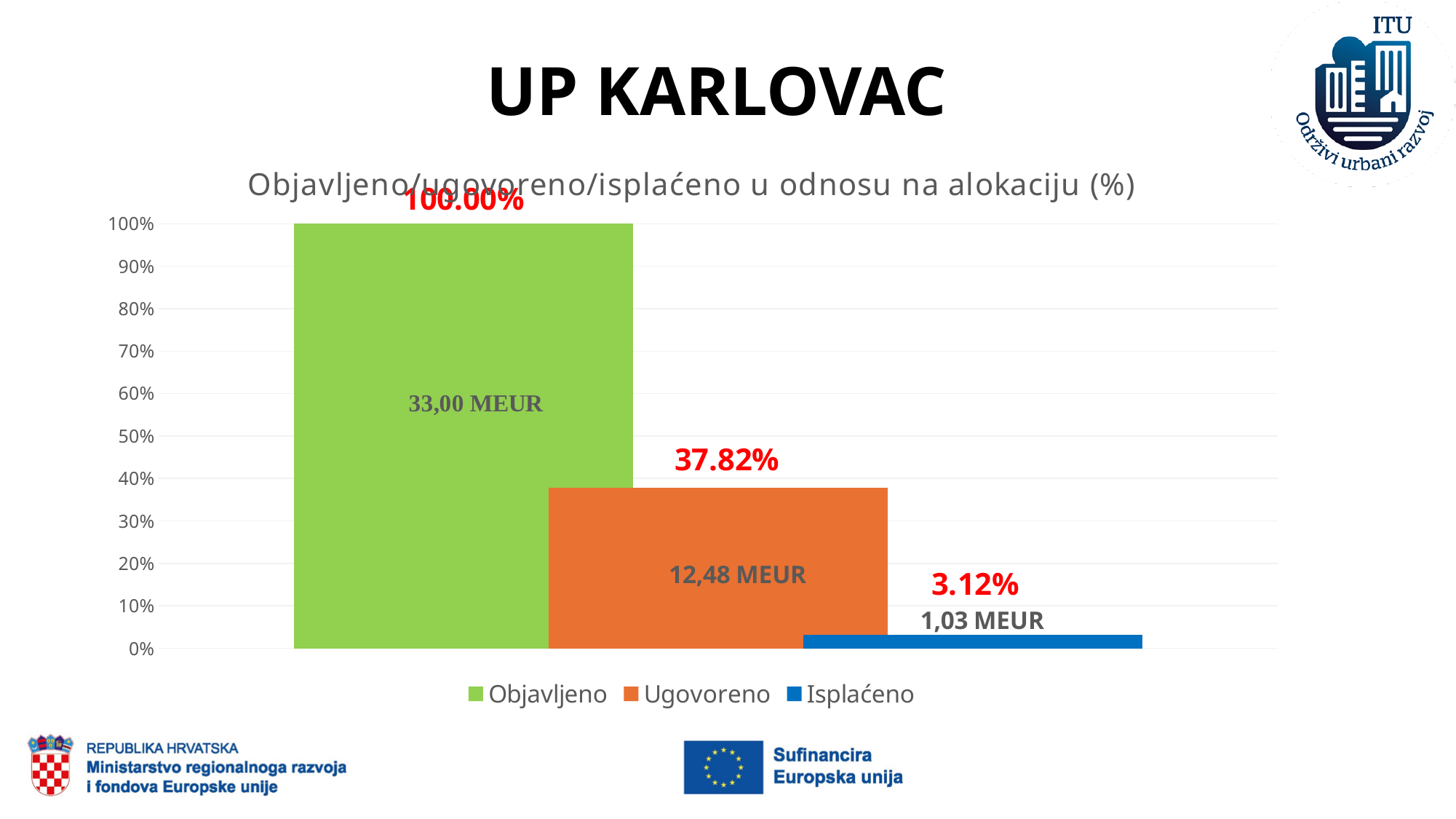
Which series has the highest percentage value? Objavljeno What amount in MEUR is labelled for Isplaćeno? 1,03 MEUR What is the title of the chart? Objavljeno/ugovoreno/isplaćeno u odnosu na alokaciju (%) Which is larger, the value for Ugovoreno or the value for Isplaćeno? Ugovoreno How many series does the legend list? 3 What percentage value is shown for Ugovoreno? 37.82% What percentage value is shown for Isplaćeno? 3.12% What percentage value is shown for Objavljeno? 100.00% What is the difference in percentage points between Objavljeno and Ugovoreno? 62.18 Which series has the lowest percentage value? Isplaćeno What kind of chart is shown on the slide? Bar chart What amount in MEUR is labelled on the Ugovoreno bar? 12,48 MEUR